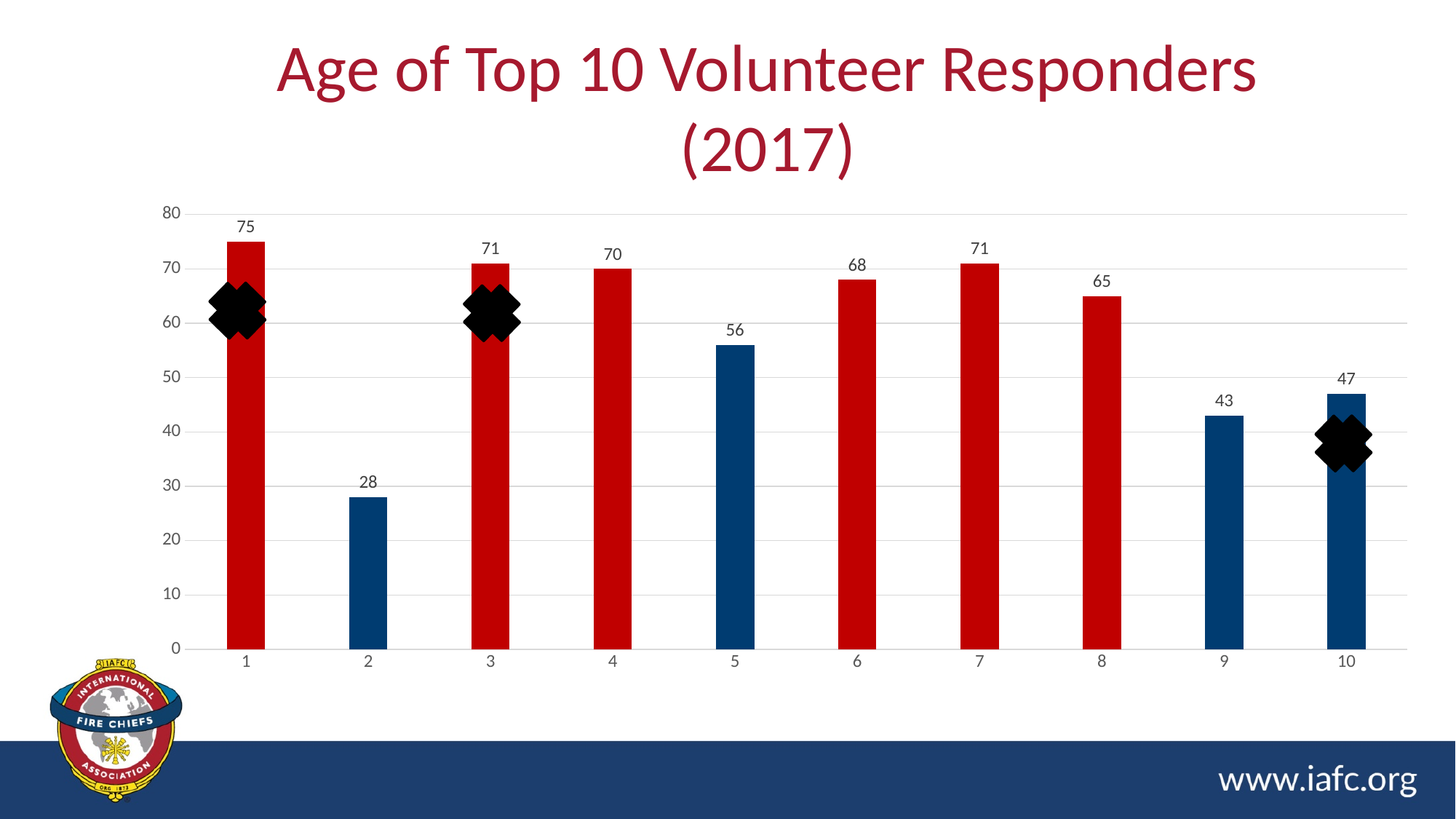
What kind of chart is shown on the slide? Bar chart What is the title of the chart? Age of Top 10 Volunteer Responders (2017) Which responder has the highest age? 1 What is the age of responder 5? 56 What is the difference in age between responder 4 and responder 9? 27 Which is older, responder 6 or responder 8? Responder 6 How many responders are shown on the chart? 10 Is the value for responder 9 greater or less than 40? greater What is the age of responder 10? 47 What is the difference in age between responder 1 and responder 2? 47 What is the age of responder 1? 75 Which responder has the lowest age? 2